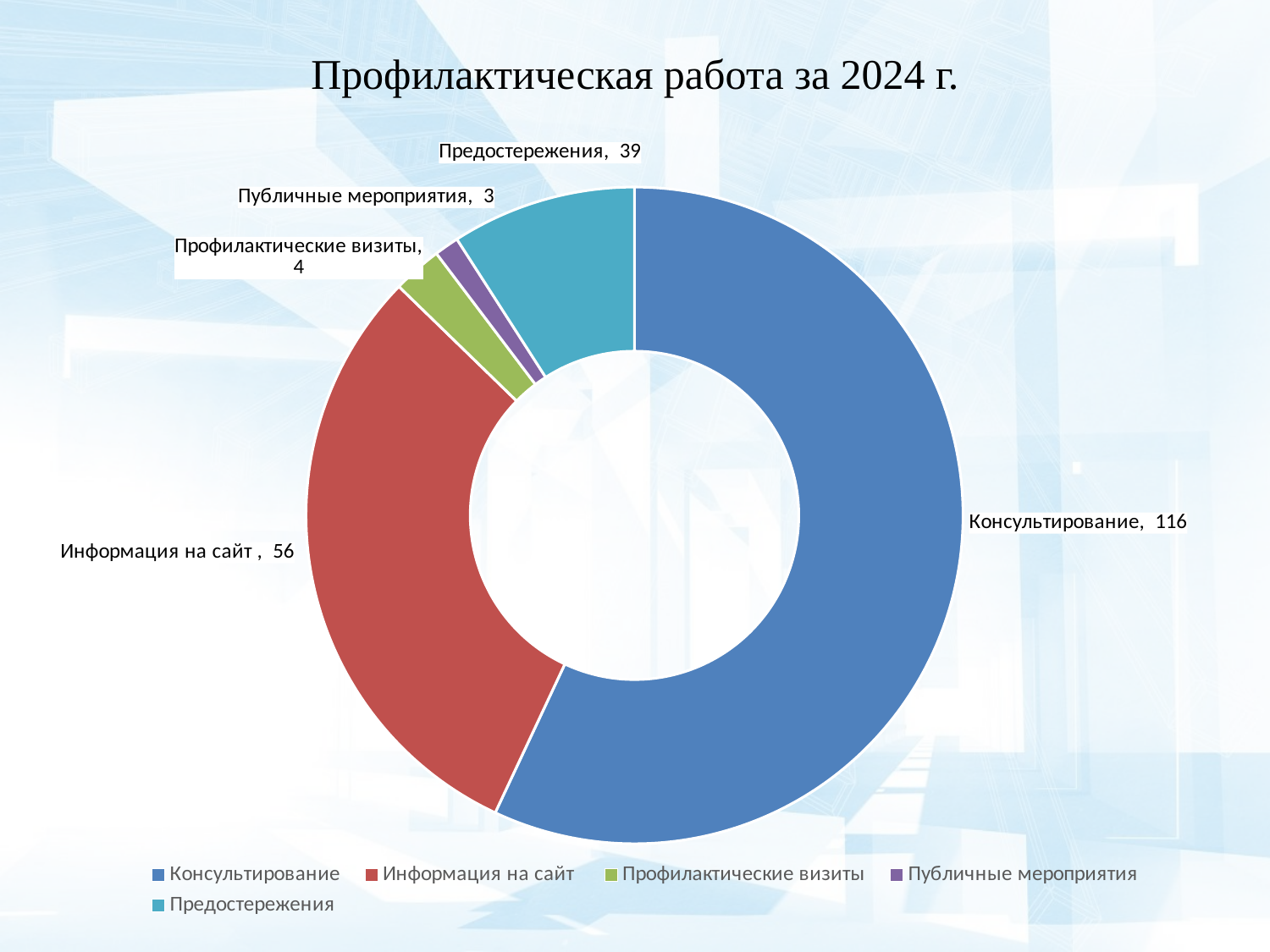
What is the title of the slide? Профилактическая работа за 2024 г. What is the value for Профилактические визиты? 4 Which is larger, the value for Предостережения or the value for Информация на сайт? Информация на сайт What is the value for Публичные мероприятия? 3 What kind of chart is shown on the slide? doughnut chart Which category has the lowest value? Публичные мероприятия What is the difference between the values for Консультирование and Информация на сайт? 60 What is the value for Информация на сайт? 56 What is the value for Консультирование? 116 What is the value for Предостережения? 39 How many categories are shown in the chart? 5 Which category has the highest value? Консультирование